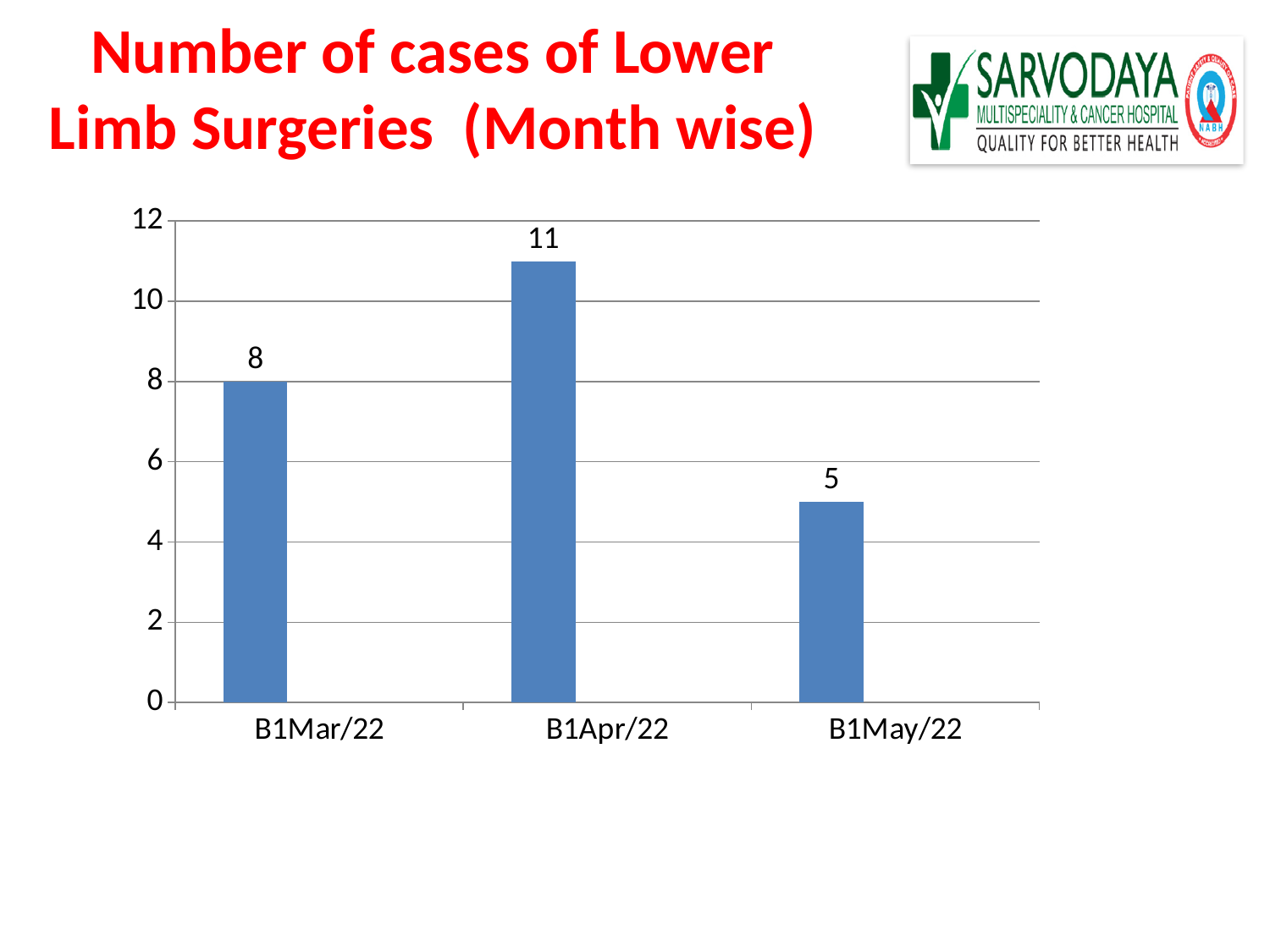
What is the difference between the number of cases in B1Mar/22 and B1May/22? 3 What is the title of the slide? Number of cases of Lower Limb Surgeries (Month wise) What is the number of cases for B1Apr/22? 11 How many months are shown on the chart? 3 Which has more cases, B1Mar/22 or B1Apr/22? B1Apr/22 Which month has the highest number of cases? B1Apr/22 What is the number of cases for B1Mar/22? 8 What kind of chart is shown on the slide? bar chart What is the difference between the number of cases in B1Apr/22 and B1May/22? 6 What is the number of cases for B1May/22? 5 Which month has the lowest number of cases? B1May/22 Is the value for B1Apr/22 greater or less than 10? greater